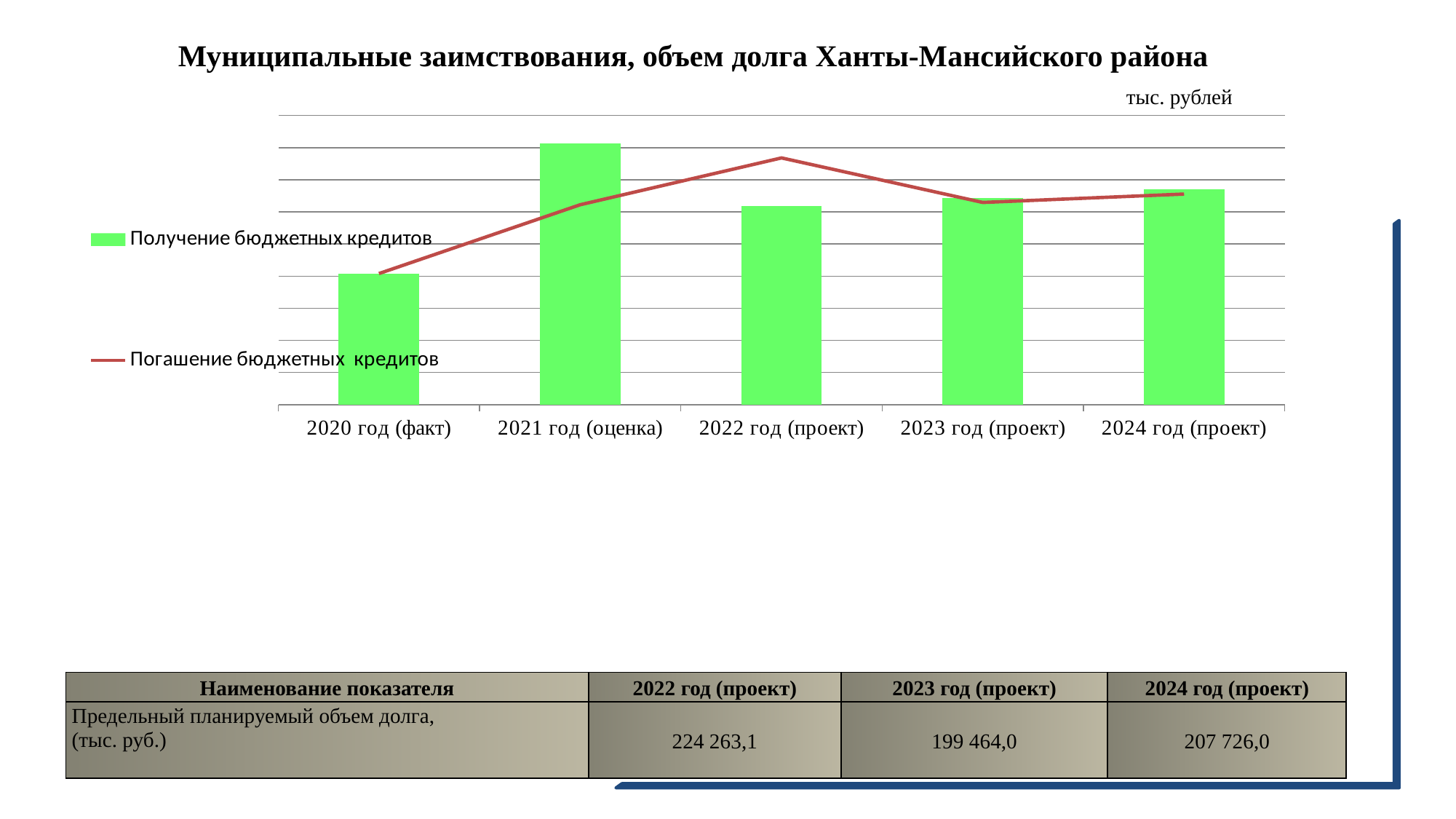
How many series does the chart legend list? 2 Which is larger for Получение бюджетных кредитов: 2020 год (факт) or 2021 год (оценка)? 2021 год (оценка) Which is larger for Получение бюджетных кредитов: 2024 год (проект) or 2020 год (факт)? 2024 год (проект) How many year categories are shown on the x axis of the chart? 5 Does the Погашение бюджетных кредитов line rise or fall from 2020 год (факт) to 2022 год (проект)? Rise Which year has the highest bar for Получение бюджетных кредитов? 2021 год (оценка) In which year does the Погашение бюджетных кредитов line reach its lowest point? 2020 год (факт) Which year has the lowest bar for Получение бюджетных кредитов? 2020 год (факт) What kind of chart is shown on the slide? A combined bar and line chart Which series is shown as green bars in the chart? Получение бюджетных кредитов What is the title of the chart? Муниципальные заимствования, объем долга Ханты-Мансийского района In which year does the Погашение бюджетных кредитов line reach its highest point? 2022 год (проект)